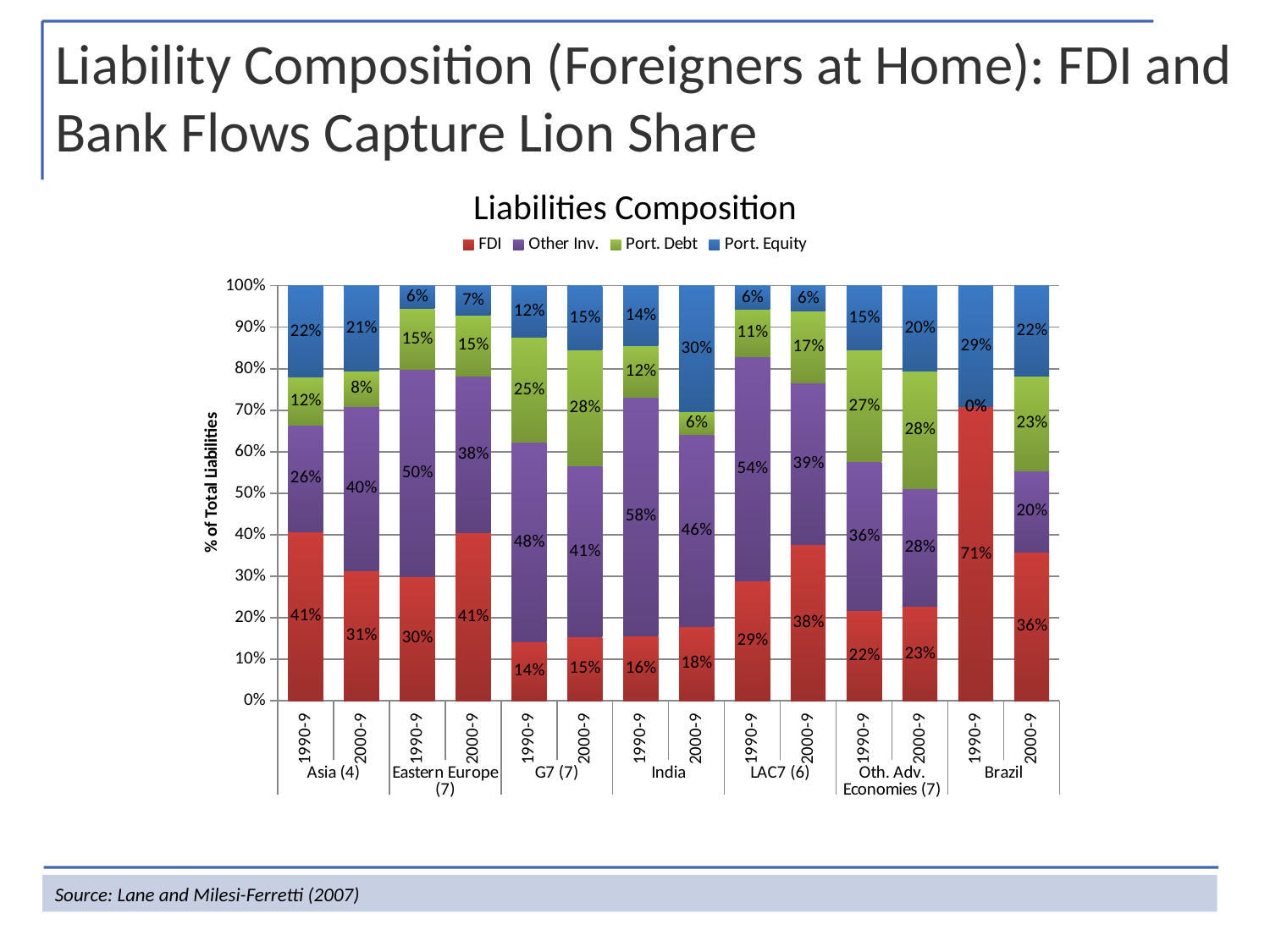
Which is larger: the Other Inv. share for India in 1990-9 or for G7 (7) in 1990-9? India 1990-9 (58%) What is the Other Inv. share for LAC7 (6) in 1990-9? 54% What is the label on the vertical axis? % of Total Liabilities How many bars are plotted in the chart? 14 What is the Port. Equity share for India in 2000-9? 30% By how many percentage points did the FDI share for Asia (4) change from 1990-9 to 2000-9? 10 percentage points (41% to 31%) Which bar has the highest FDI share? Brazil 1990-9 (71%) Which bar has the lowest FDI share? G7 (7) 1990-9 (14%) What is the Port. Debt share for Oth. Adv. Economies (7) in 2000-9? 28% How many series does the legend list? 4 What is the FDI share for Asia (4) in 1990-9? 41% What type of chart is shown? Stacked bar chart